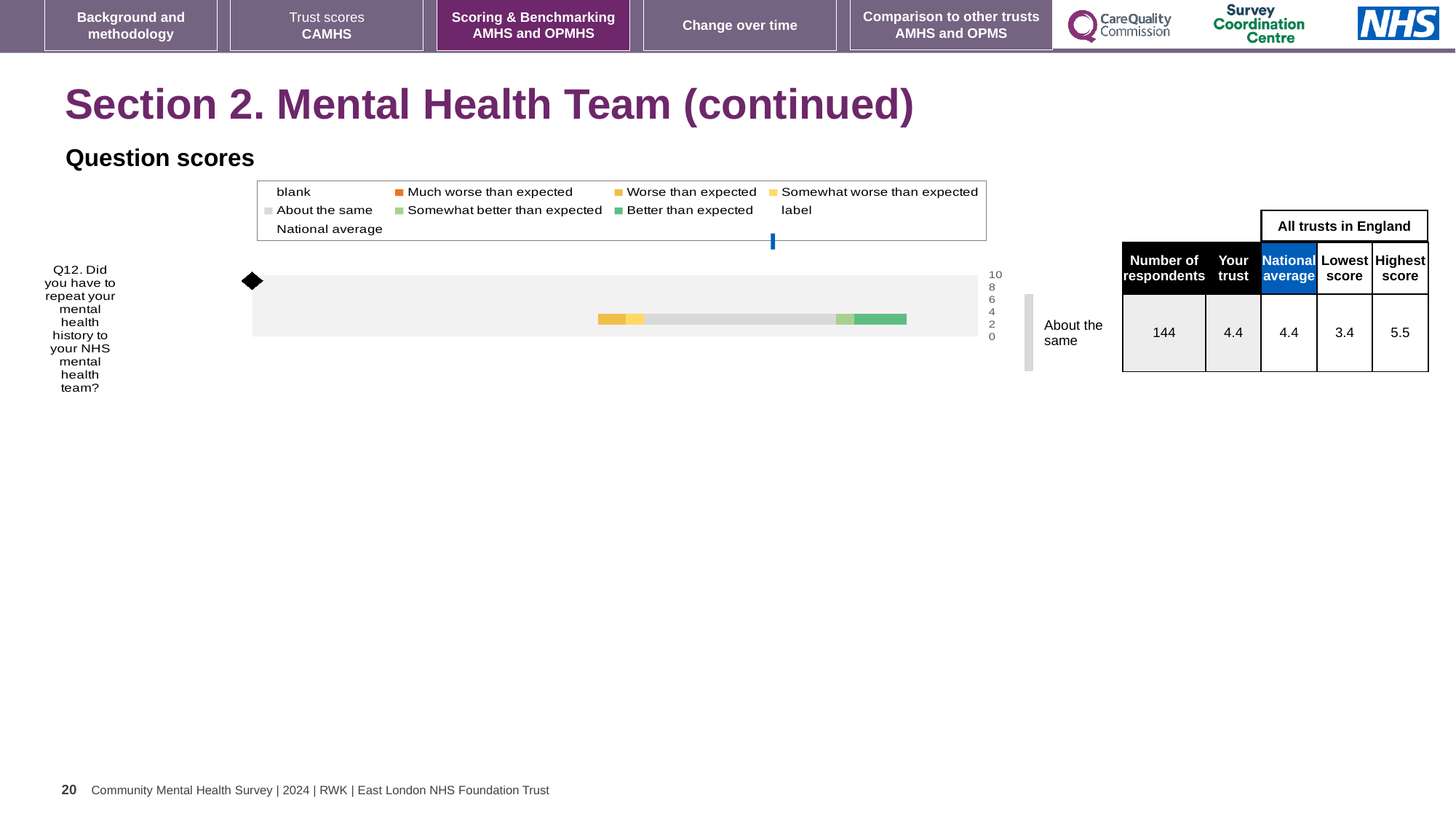
In the table beside the chart, what is the difference between the highest score and the lowest score for Q12? 2.1 In the table beside the chart, what is the national average score for Q12? 4.4 In the table beside the chart, what is the highest score among all trusts in England for Q12? 5.5 What kind of chart is shown on the slide? bar chart In the table beside the chart, what is the number of respondents for Q12? 144 In the table beside the chart, what is the 'Your trust' score for Q12? 4.4 How many question categories are plotted on the chart? 1 In the table beside the chart, is the 'Your trust' score for Q12 larger than, smaller than, or equal to the national average? equal Which question is plotted on the chart? Q12. Did you have to repeat your mental health history to your NHS mental health team? What is the highest value shown on the chart's axis? 10 What benchmark category label is shown to the right of the chart for Q12? About the same In the table beside the chart, what is the lowest score among all trusts in England for Q12? 3.4